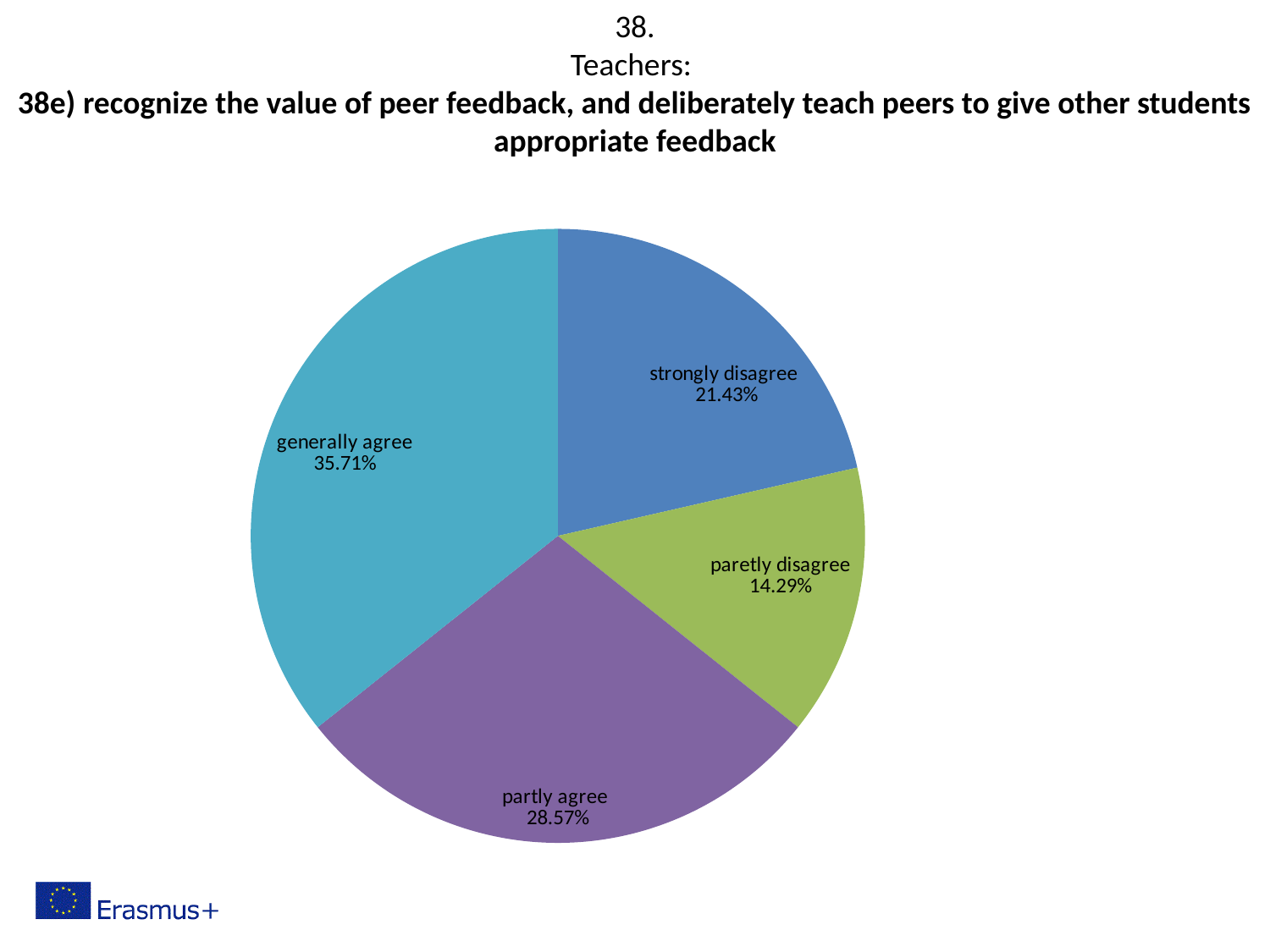
What percentage of teachers chose 'generally agree'? 35.71% What percentage of teachers chose 'partly agree'? 28.57% What percentage of teachers chose 'paretly disagree'? 14.29% What is the combined share of 'generally agree' and 'partly agree'? 64.28% What colour is the 'partly agree' slice? purple What is the difference in percentage points between 'generally agree' and 'partly agree'? 7.14 Which response category has the largest share of the pie? generally agree How many slices does the pie chart have? 4 What percentage of teachers chose 'strongly disagree'? 21.43% What kind of chart is shown on the slide? pie chart Which response category has the smallest share of the pie? paretly disagree Which is larger, the share for 'strongly disagree' or the share for 'paretly disagree'? strongly disagree